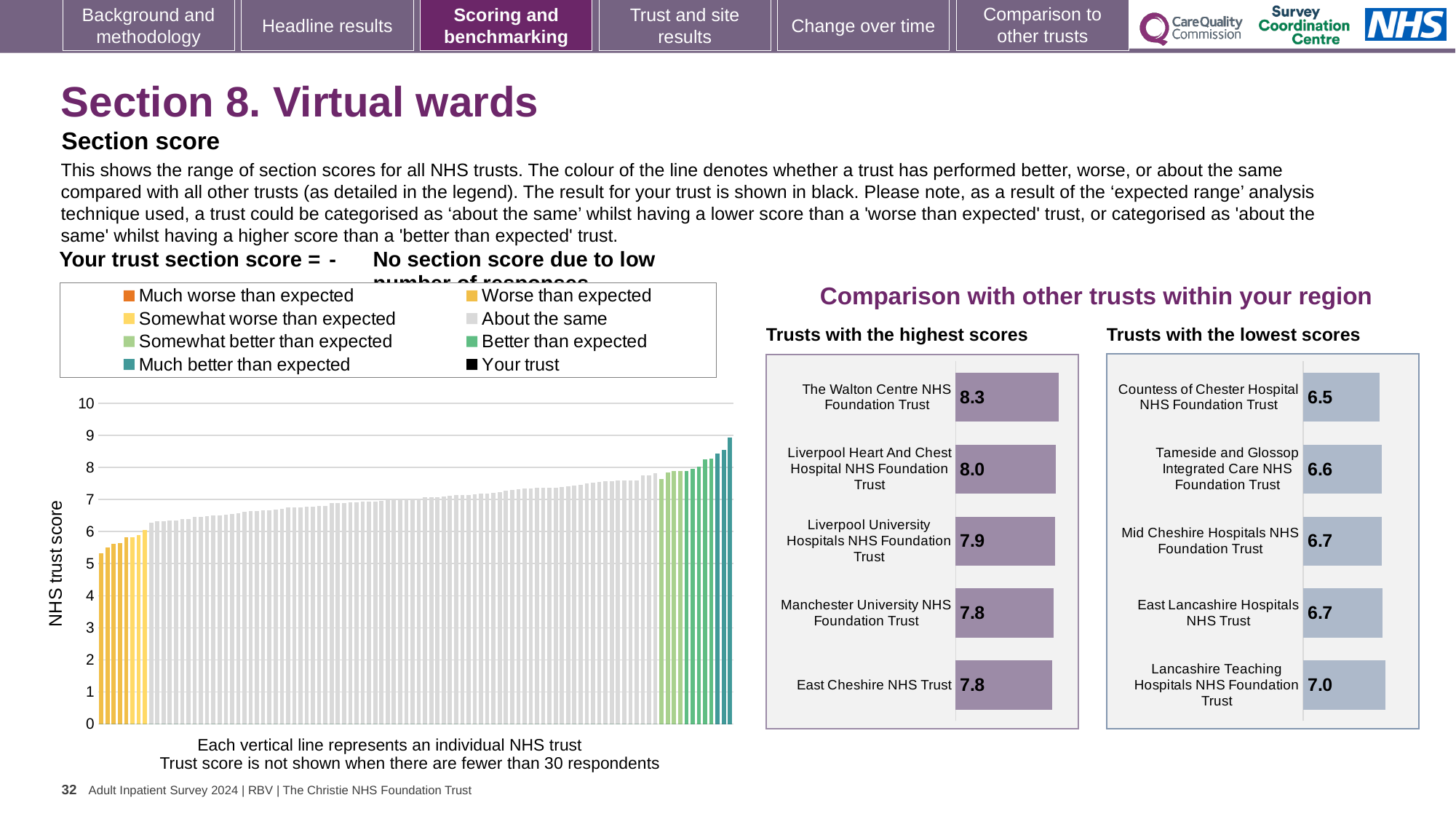
In the large 'NHS trust score' chart on the left, is the value of the tallest bar greater or less than 8? greater How many trusts are shown in the 'Trusts with the highest scores' chart? 5 In the large 'NHS trust score' chart on the left, is the value of the shortest bar greater or less than 6? less In the 'Trusts with the lowest scores' chart, what is the score for Countess of Chester Hospital NHS Foundation Trust? 6.5 In the 'Trusts with the highest scores' chart, what is the difference between the scores of The Walton Centre NHS Foundation Trust and East Cheshire NHS Trust? 0.5 In the 'Trusts with the highest scores' chart, which trust has the highest score? The Walton Centre NHS Foundation Trust In the 'Trusts with the highest scores' chart, what is the score for Liverpool University Hospitals NHS Foundation Trust? 7.9 How many entries does the legend above the large 'NHS trust score' chart list? 8 In the 'Trusts with the lowest scores' chart, what is the score for Lancashire Teaching Hospitals NHS Foundation Trust? 7.0 In the 'Trusts with the lowest scores' chart, which trust has the lowest score? Countess of Chester Hospital NHS Foundation Trust In the 'Trusts with the lowest scores' chart, which has the larger score: Tameside and Glossop Integrated Care NHS Foundation Trust or Lancashire Teaching Hospitals NHS Foundation Trust? Lancashire Teaching Hospitals NHS Foundation Trust In the 'Trusts with the highest scores' chart, what is the score for The Walton Centre NHS Foundation Trust? 8.3